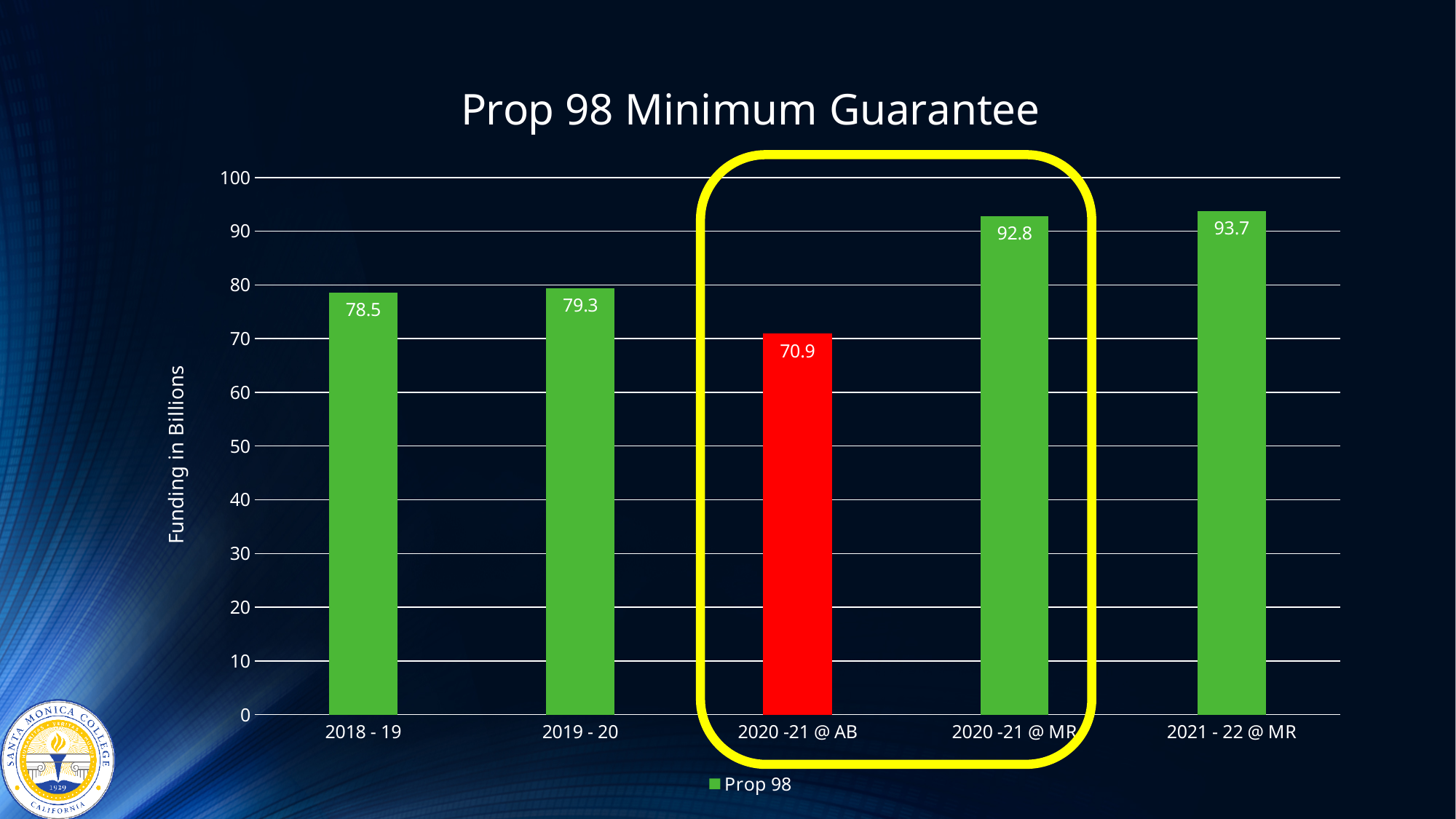
Is the value for 2020 -21 @ MR greater or less than 80? greater Which category has the highest value? 2021 - 22 @ MR What is the title of the chart? Prop 98 Minimum Guarantee What is the value for 2021 - 22 @ MR? 93.7 How many series does the legend list? 1 What kind of chart is this? bar chart What is the value for 2018 - 19? 78.5 Which category has the lowest value? 2020 -21 @ AB How many categories are shown on the x axis? 5 Which is larger, the value for 2019 - 20 or the value for 2018 - 19? 2019 - 20 What is the difference between the values for 2020 -21 @ MR and 2020 -21 @ AB? 21.9 What is the value for 2020 -21 @ AB? 70.9